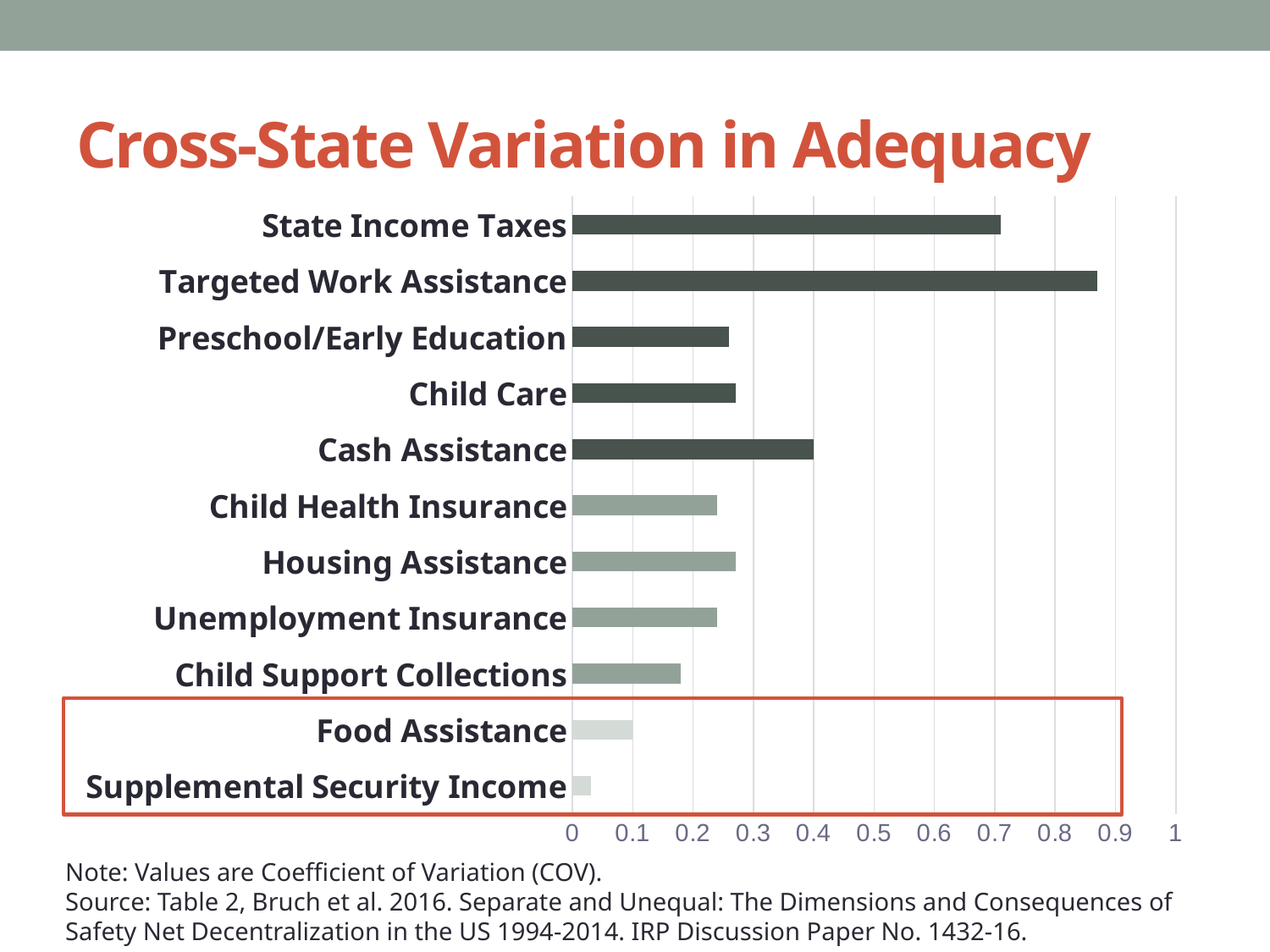
Which is larger, the value for State Income Taxes or the value for Targeted Work Assistance? Targeted Work Assistance Which category has the highest value in the chart? Targeted Work Assistance Which is larger, the value for Cash Assistance or the value for Child Care? Cash Assistance Is the value for Cash Assistance greater or less than 0.3? greater What is the title of the chart on the slide? Cross-State Variation in Adequacy Which category has the lowest value in the chart? Supplemental Security Income How many categories are plotted in the chart? 11 Is the value for Targeted Work Assistance greater or less than 0.8? greater Is the value for Food Assistance greater or less than 0.2? less What kind of chart is shown on the slide? bar chart